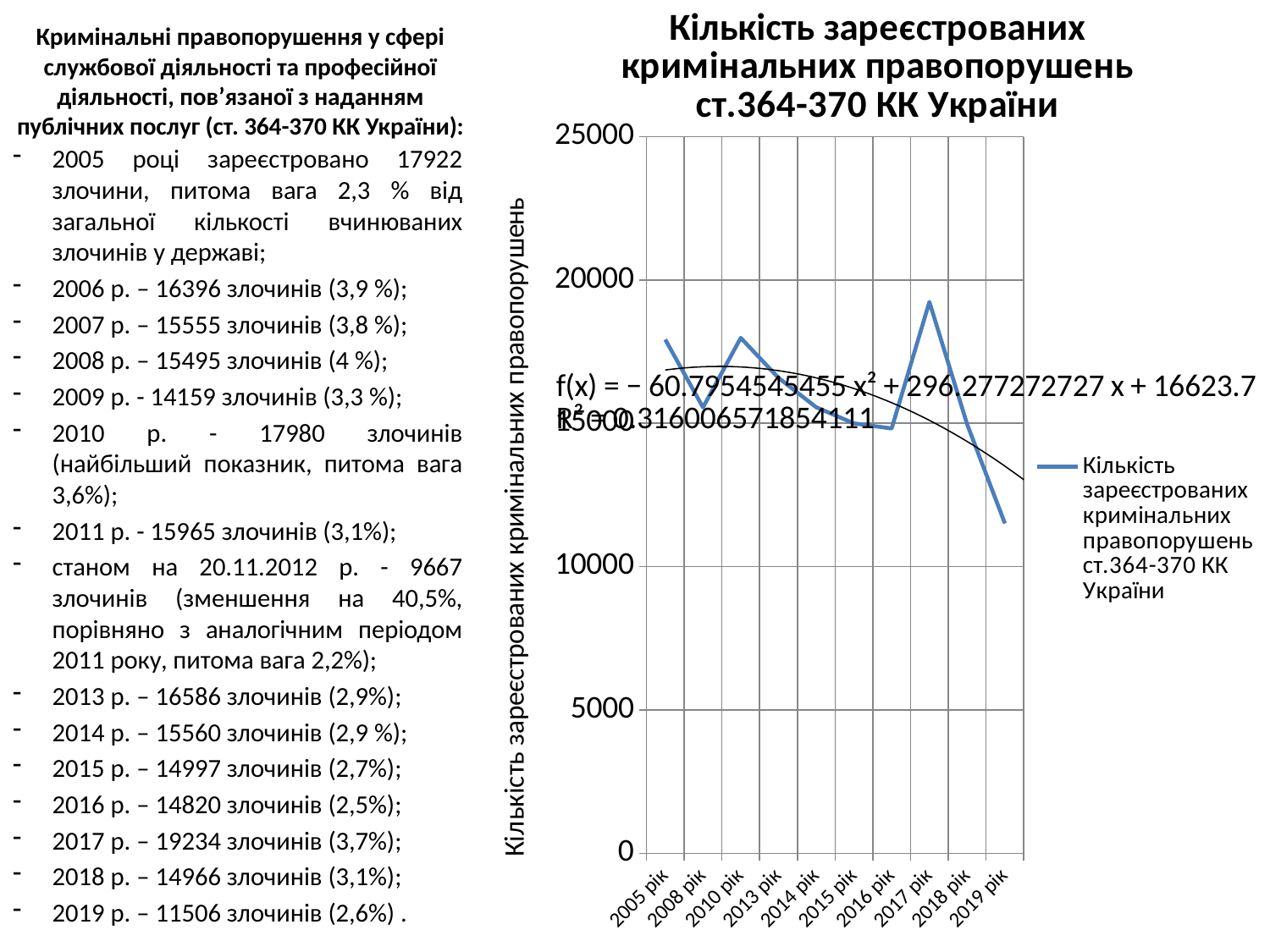
Is the value for 2017 рік greater or less than 20000? less Which year has the lowest number of registered criminal offences in the chart? 2019 рік Which year has the larger value, 2010 рік or 2013 рік? 2010 рік What kind of chart is shown on the slide? line chart How many years (categories) are plotted along the x axis of the chart? 10 Is the value for 2005 рік greater or less than 15000? greater Which year has the highest number of registered criminal offences in the chart? 2017 рік What is the title of the chart? Кількість зареєстрованих кримінальних правопорушень ст.364-370 КК України Is the value for 2019 рік greater or less than 10000? greater How many series does the chart legend list? 1 Which year has the larger value, 2005 рік or 2019 рік? 2005 рік